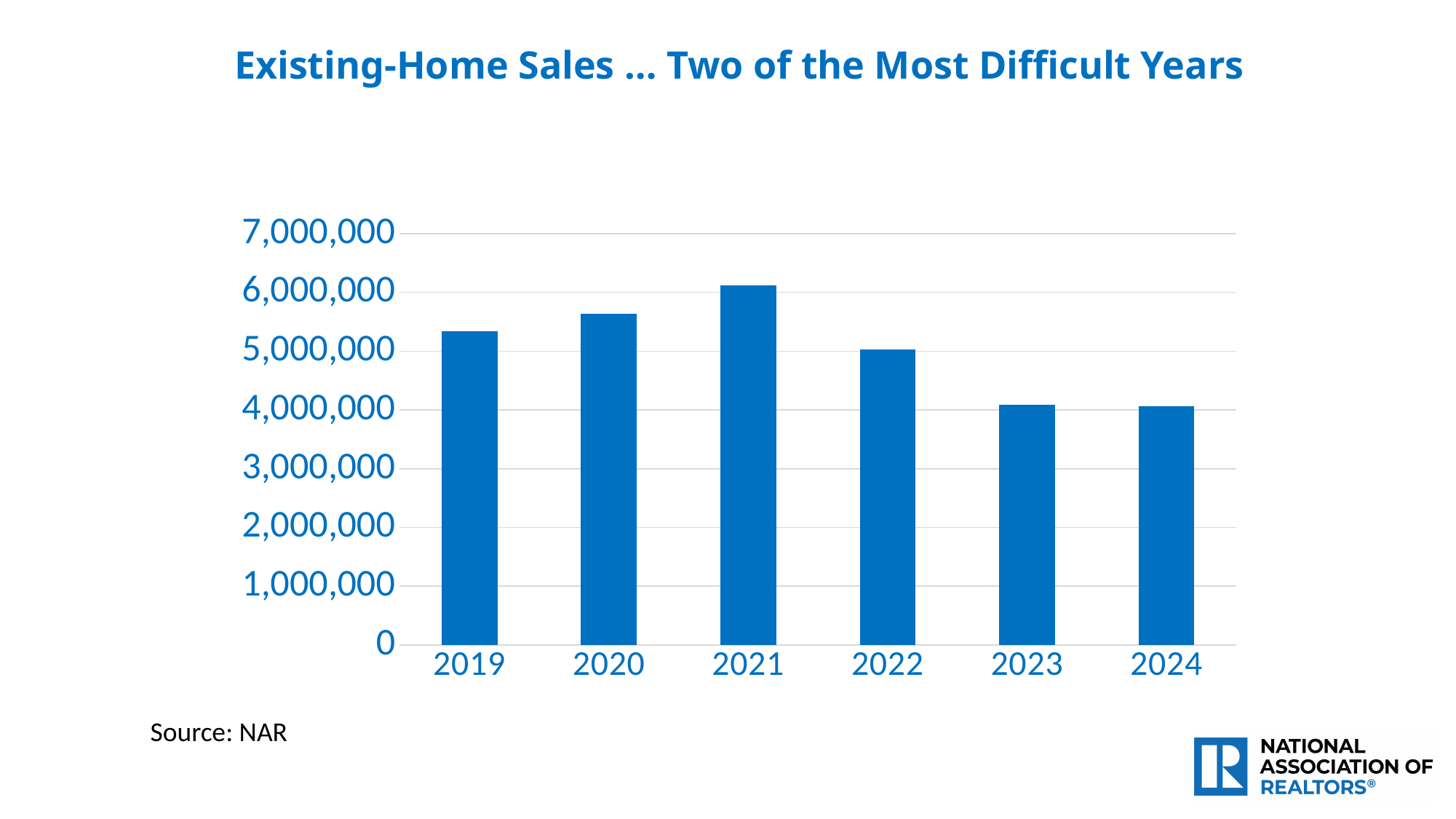
How many years are shown on the x axis of the chart? 6 Which is larger, the value for 2020 or the value for 2022? 2020 Is the value for 2019 greater or less than 5,000,000? greater What source is cited below the chart? NAR Is the value for 2020 greater or less than 6,000,000? less Which year has the highest existing-home sales in the chart? 2021 Do the values rise or fall from 2021 to 2024? fall Is the value for 2023 greater or less than 5,000,000? less What is the title of the chart? Existing-Home Sales … Two of the Most Difficult Years Which is larger, the value for 2021 or the value for 2019? 2021 What kind of chart is shown on the slide? bar chart